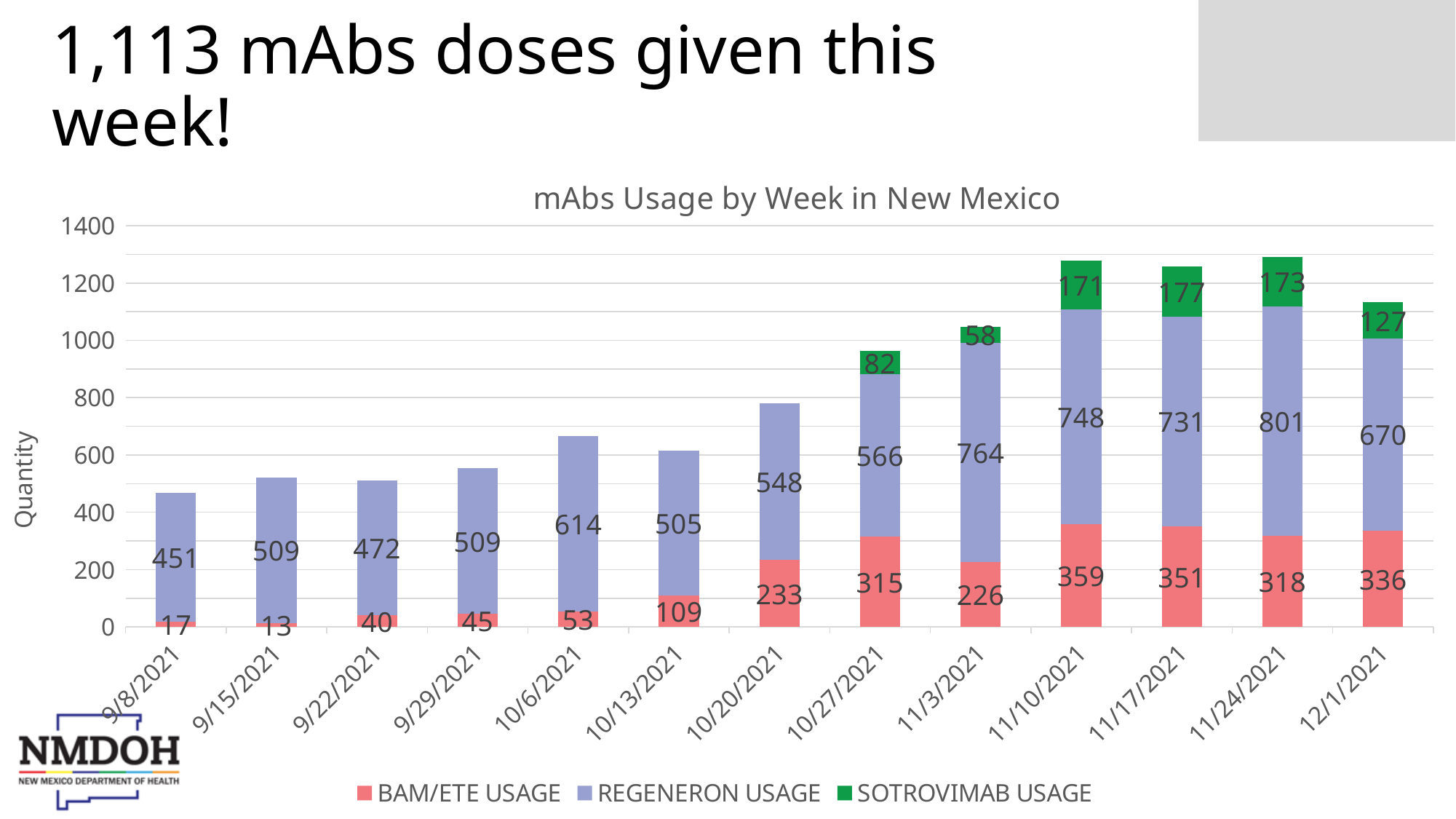
Which is larger: BAM/ETE USAGE on 11/10/2021 or on 11/17/2021? 11/10/2021 What is the REGENERON USAGE value for the week of 11/24/2021? 801 What is the SOTROVIMAB USAGE value for the week of 12/1/2021? 127 How many series does the legend list? 3 Which week has the highest REGENERON USAGE? 11/24/2021 How many weeks are shown on the x axis? 13 Which week has the highest SOTROVIMAB USAGE? 11/17/2021 Which week has the lowest BAM/ETE USAGE? 9/15/2021 What is the difference between REGENERON USAGE on 11/24/2021 and on 12/1/2021? 131 Is the total stacked bar for 9/8/2021 greater or less than 400? greater What is the BAM/ETE USAGE value for the week of 10/20/2021? 233 What is the total of the stacked bar for 11/24/2021? 1292